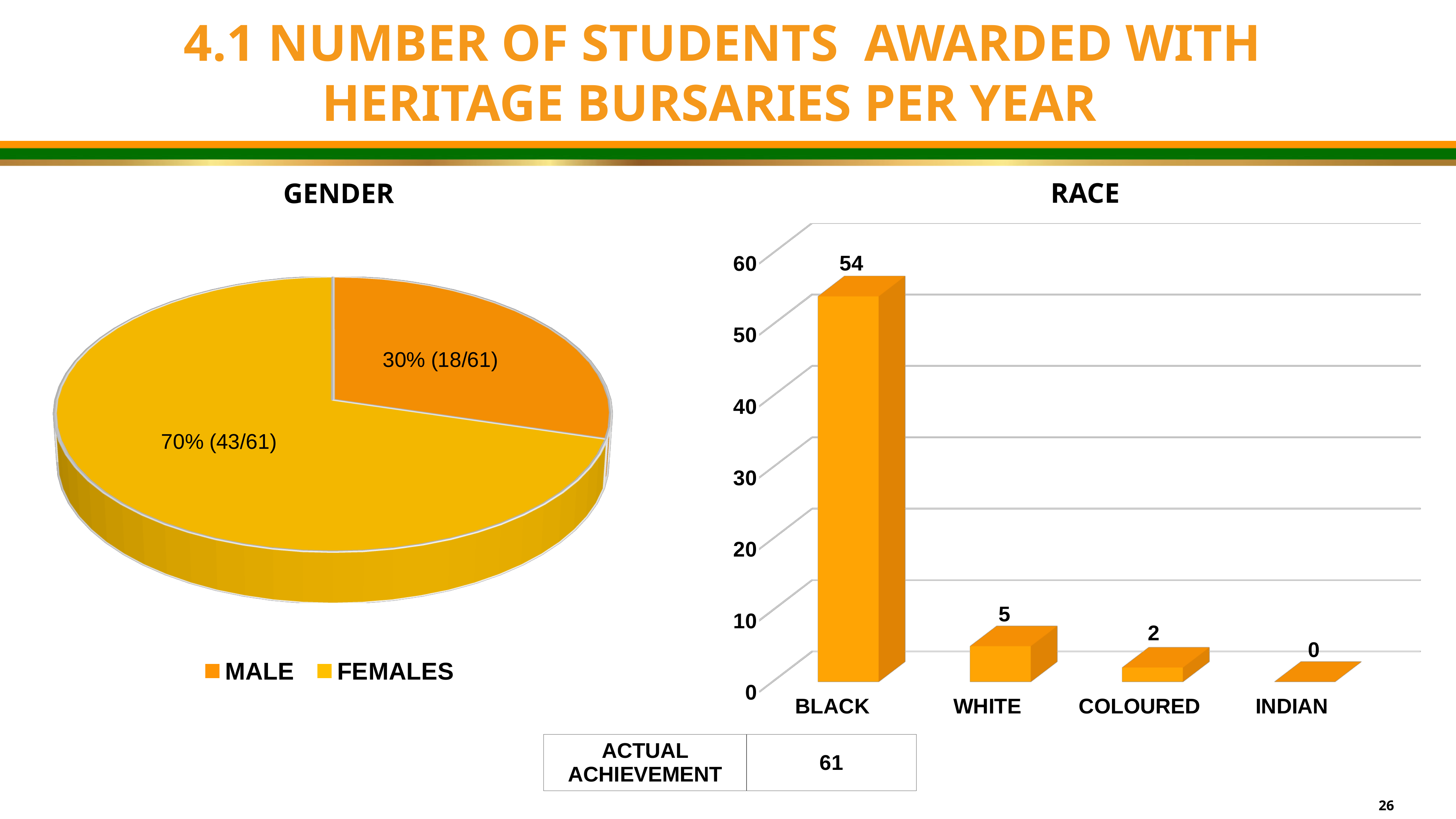
In the RACE chart, which category has the highest value? BLACK In the RACE chart, what is the value for WHITE? 5 In the GENDER chart, what share of the pie is FEMALES? 70% In the RACE chart, which is larger, the value for WHITE or the value for COLOURED? WHITE In the RACE chart, how many categories are shown on the x axis? 4 What kind of chart is the RACE chart? bar chart What kind of chart is the GENDER chart? pie chart In the RACE chart, what is the difference between the values for BLACK and WHITE? 49 In the GENDER chart, what is the label shown on the MALE slice? 30% (18/61) In the RACE chart, which category has the lowest value? INDIAN In the RACE chart, what is the value for BLACK? 54 In the RACE chart, what is the value for COLOURED? 2